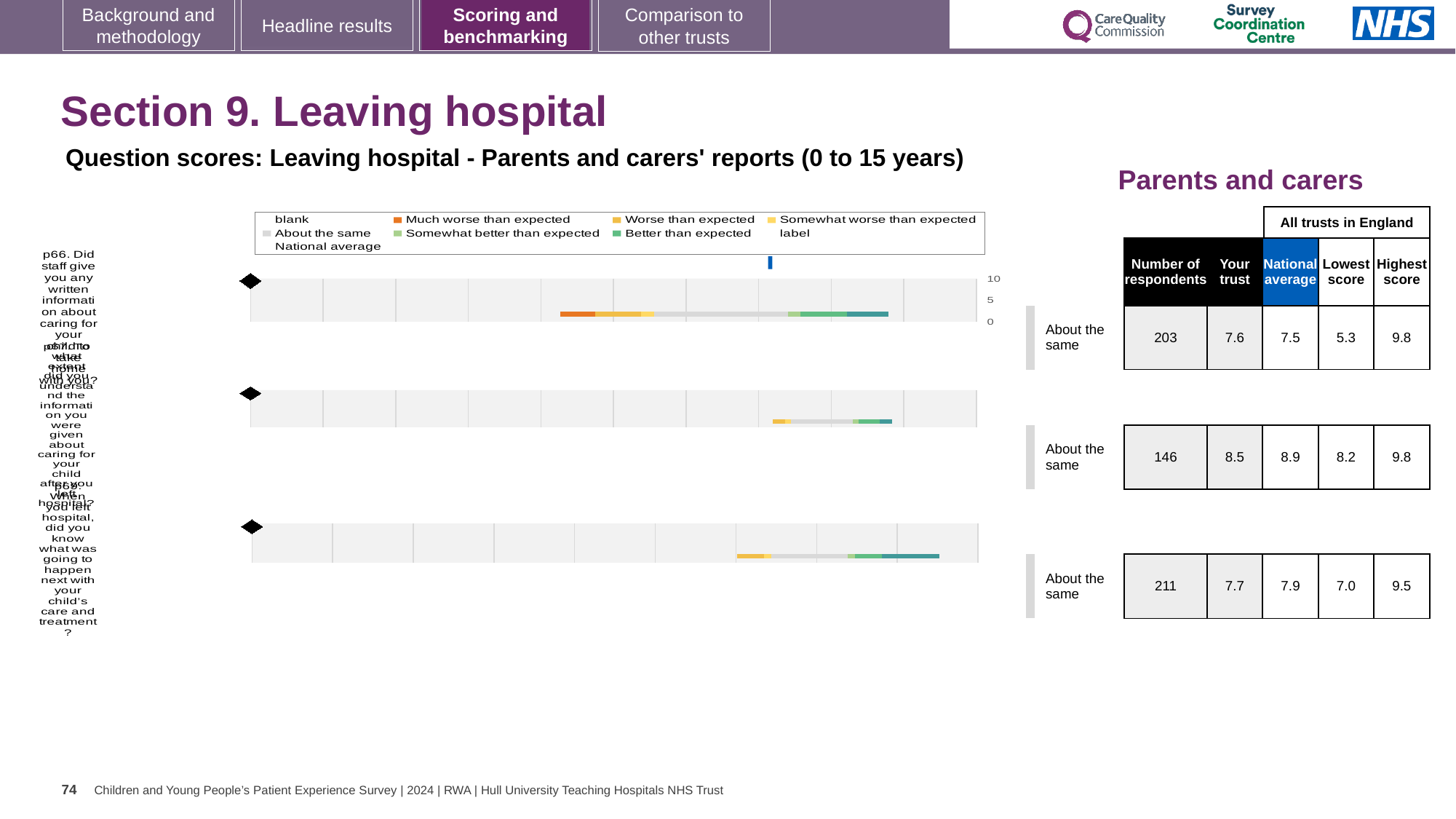
Which colour does the legend use for 'Much worse than expected'? orange How many entries does the legend above the charts list? 9 How many question charts are plotted on the slide? 3 In the Parents and carers table, what is the national average for the third question (p68, knowing what was going to happen next)? 7.9 In the Parents and carers table, how many respondents answered the second question? 146 In the Parents and carers table, what is the lowest score across all trusts in England for the first question (p66)? 5.3 In the Parents and carers table, what is the difference between the highest score and the lowest score for the third question (p68)? 2.5 In the Parents and carers table, what is the 'Your trust' score for the first question (p66, written information about caring for your child at home)? 7.6 What kind of chart is used to show the question scores on this slide? bar chart In the Parents and carers table, which of the three questions has the highest 'Your trust' score? the second question (8.5) What is the highest tick value shown on the score axis of the charts? 10 In the Parents and carers table, is the 'Your trust' score for the first question (p66) higher or lower than the national average? higher